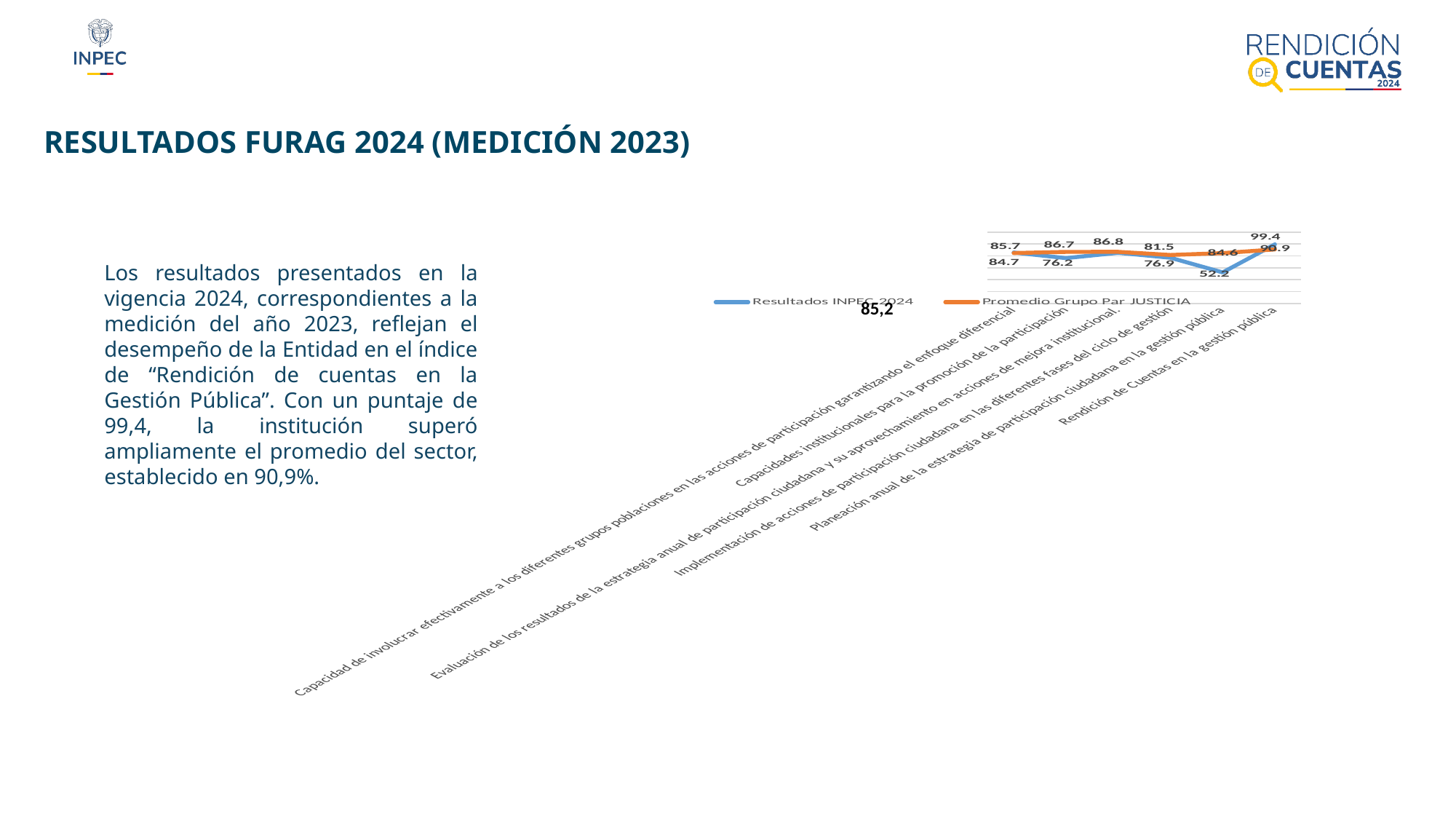
What kind of chart is shown on the slide? line chart What is the lowest value plotted for the Resultados INPEC 2024 series? 52.2 What is the value of Promedio Grupo Par JUSTICIA for 'Rendición de Cuentas en la gestión pública'? 90.9 What is the value of Resultados INPEC 2024 for 'Rendición de Cuentas en la gestión pública'? 99.4 For 'Planeación anual de la estrategia de participación ciudadana en la gestión pública', which series has the larger value? Promedio Grupo Par JUSTICIA Which colour is used for the Promedio Grupo Par JUSTICIA line? orange What are the two series named in the chart legend? Resultados INPEC 2024 and Promedio Grupo Par JUSTICIA What is the difference between Resultados INPEC 2024 and Promedio Grupo Par JUSTICIA for 'Rendición de Cuentas en la gestión pública'? 8.5 How many series does the chart legend list? 2 How many categories are plotted along the x axis of the chart? 6 For 'Rendición de Cuentas en la gestión pública', which series has the larger value, Resultados INPEC 2024 or Promedio Grupo Par JUSTICIA? Resultados INPEC 2024 What is the highest value plotted for the Resultados INPEC 2024 series? 99.4